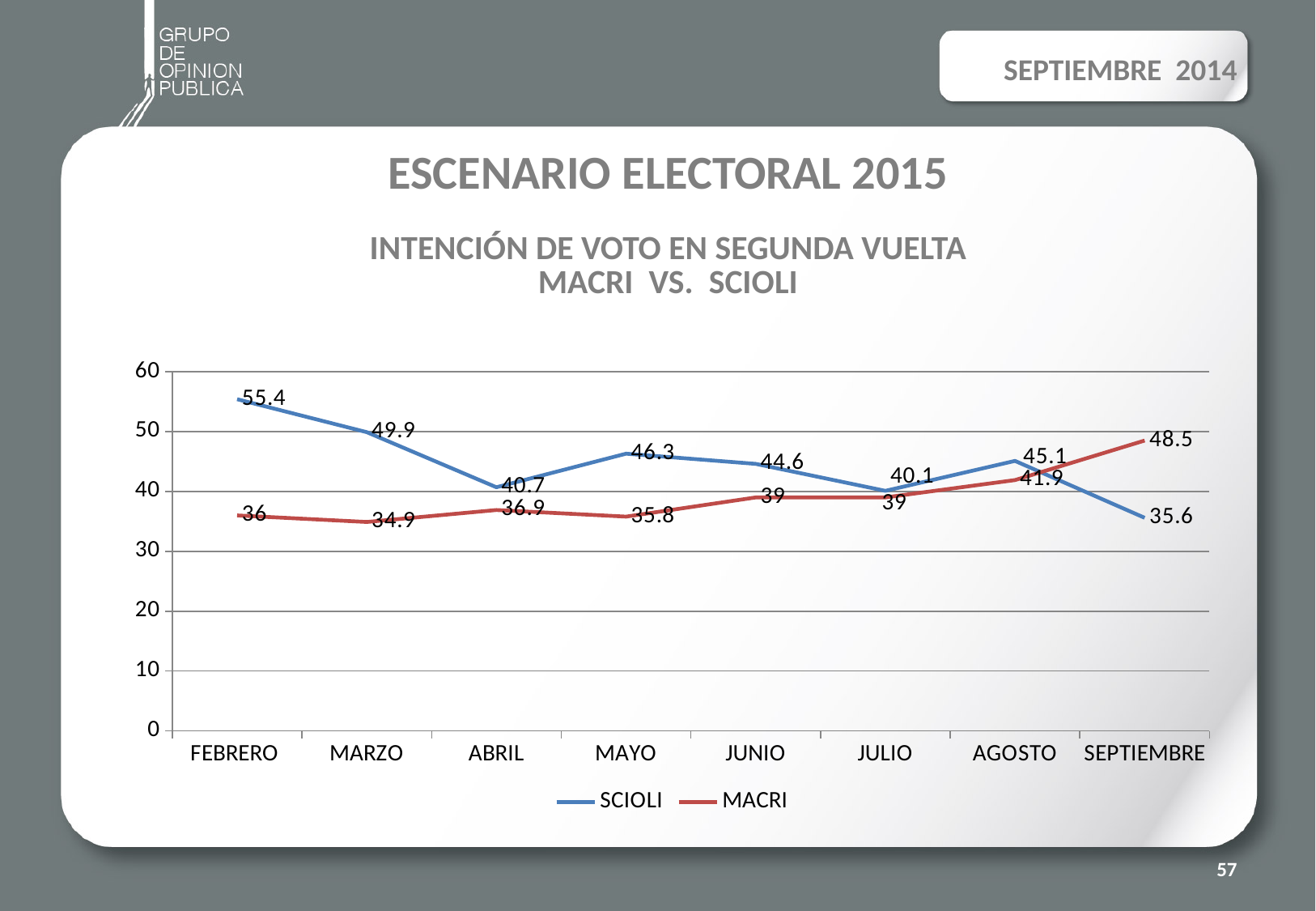
What is the value for SCIOLI in FEBRERO? 55.4 What kind of chart is shown on the slide? Line chart Does the MACRI line rise or fall from JULIO to SEPTIEMBRE? Rise What is the value for MACRI in SEPTIEMBRE? 48.5 Which series has the larger value in SEPTIEMBRE, SCIOLI or MACRI? MACRI How many months are shown on the x axis? 8 How many series does the legend list? 2 What is the value for SCIOLI in JULIO? 40.1 What is the difference between the SCIOLI and MACRI values in FEBRERO? 19.4 In which month is the MACRI value lowest? MARZO What is the value for MACRI in MARZO? 34.9 In which month is the SCIOLI value highest? FEBRERO